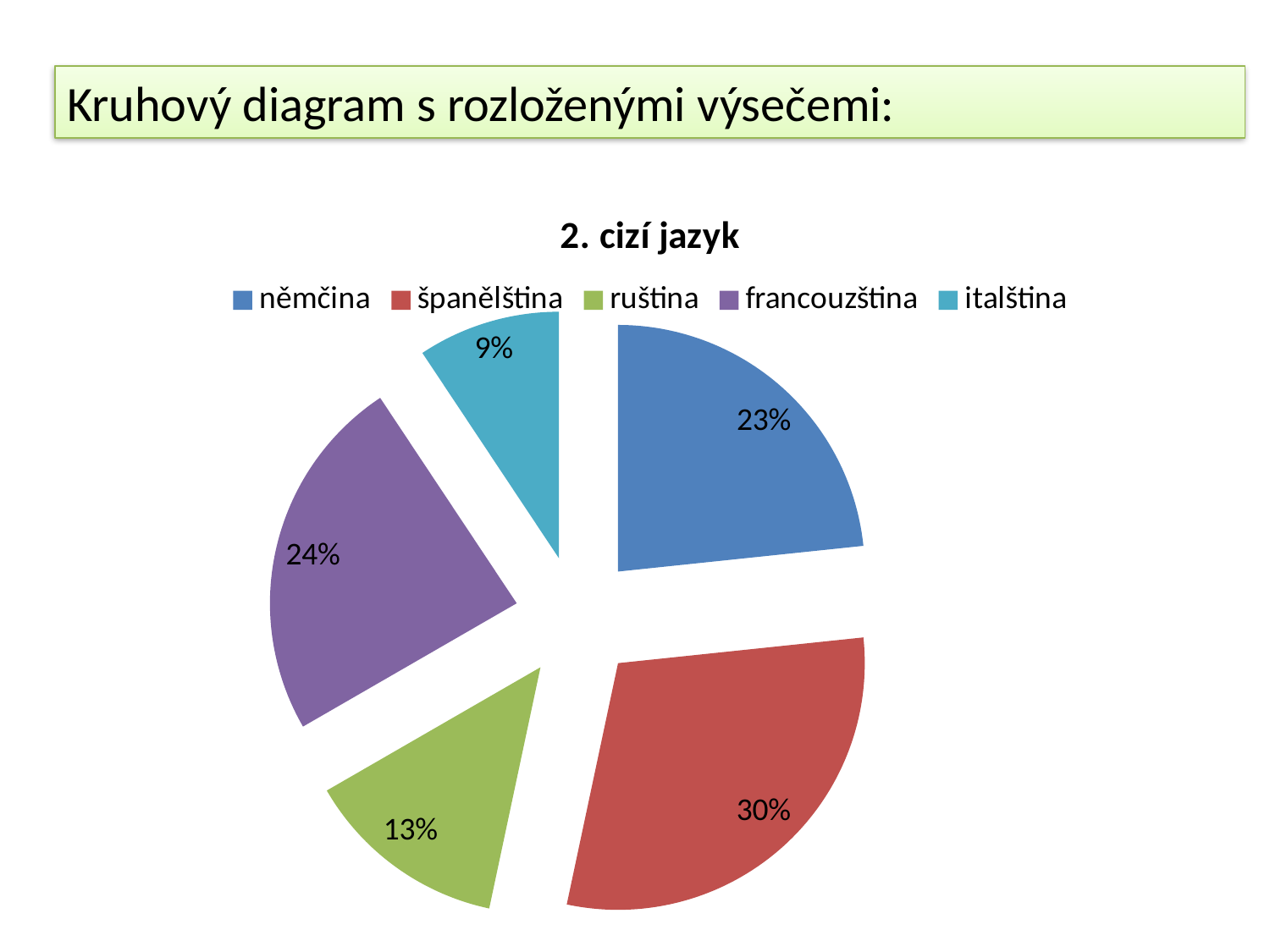
What share of the pie does italština have? 9% Which language has the largest slice of the pie? španělština What share of the pie does francouzština have? 24% What kind of chart is shown on the slide? pie chart Which has a larger share, němčina or francouzština? francouzština Which language has the smallest slice of the pie? italština What share of the pie does španělština have? 30% What is the title of the chart? 2. cizí jazyk What is the difference between the shares of španělština and ruština? 17% What share of the pie does němčina have? 23% How many slices does the pie chart have? 5 What share of the pie does ruština have? 13%